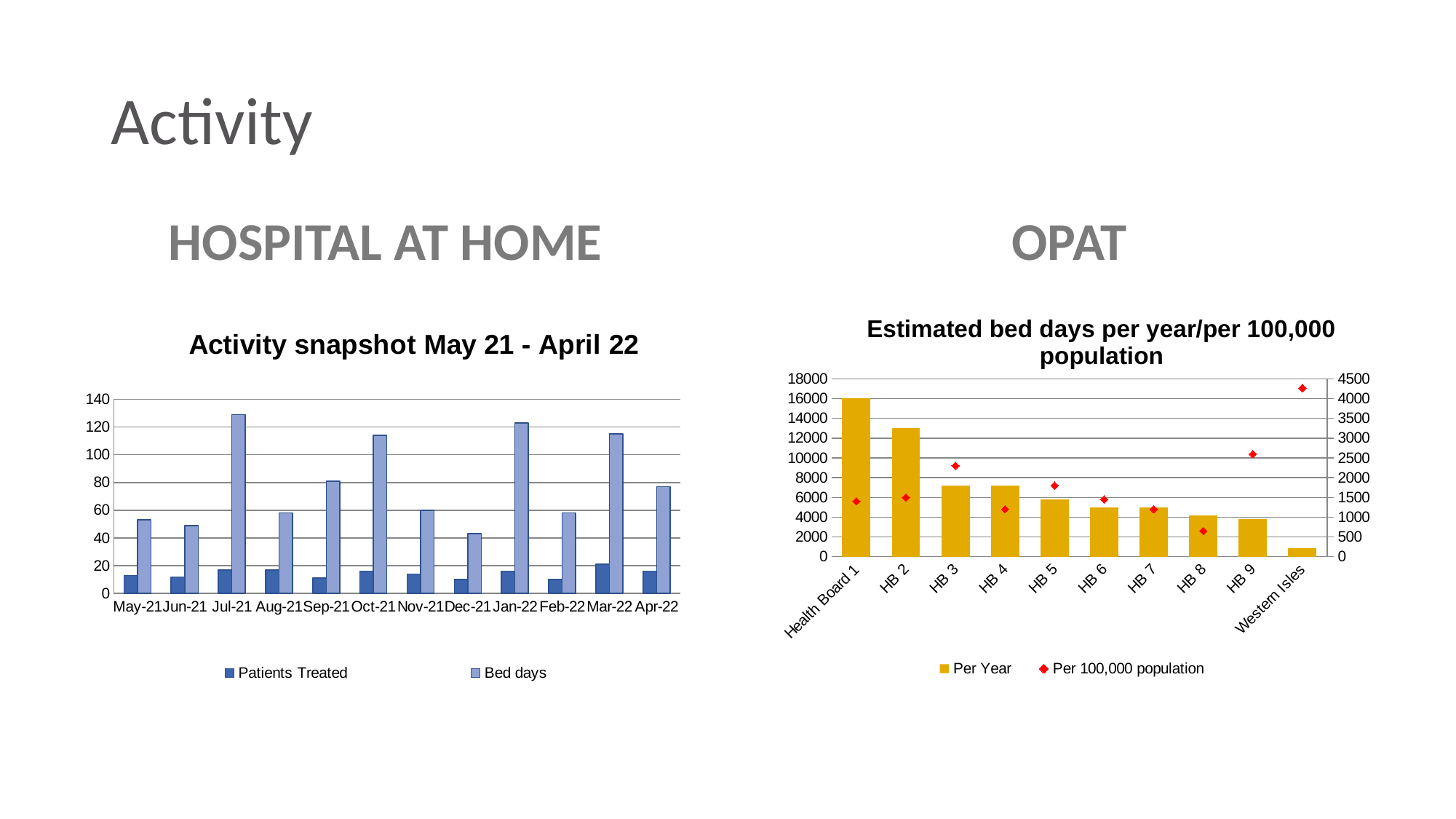
How many series does the legend of the 'Activity snapshot May 21 - April 22' chart list? 2 What kind of chart is the 'Activity snapshot May 21 - April 22' chart? bar chart In the 'Activity snapshot May 21 - April 22' chart, which month has the highest Patients Treated value? Mar-22 In the 'Activity snapshot May 21 - April 22' chart, is the Bed days value for Jul-21 greater or less than 120? greater In the 'Activity snapshot May 21 - April 22' chart, is the Bed days value for Dec-21 greater or less than 60? less In the 'Estimated bed days per year/per 100,000 population' chart, which category has the highest Per 100,000 population value? Western Isles In the 'Estimated bed days per year/per 100,000 population' chart, do the Per Year bars rise or fall from left to right? fall In the 'Estimated bed days per year/per 100,000 population' chart, which category has the lowest Per Year value? Western Isles How many categories are shown on the x axis of the 'Estimated bed days per year/per 100,000 population' chart? 10 How many months are shown on the x axis of the 'Activity snapshot May 21 - April 22' chart? 12 In the 'Estimated bed days per year/per 100,000 population' chart, which category has the highest Per Year value? Health Board 1 In the 'Activity snapshot May 21 - April 22' chart, which month has the larger Bed days value, Sep-21 or Oct-21? Oct-21